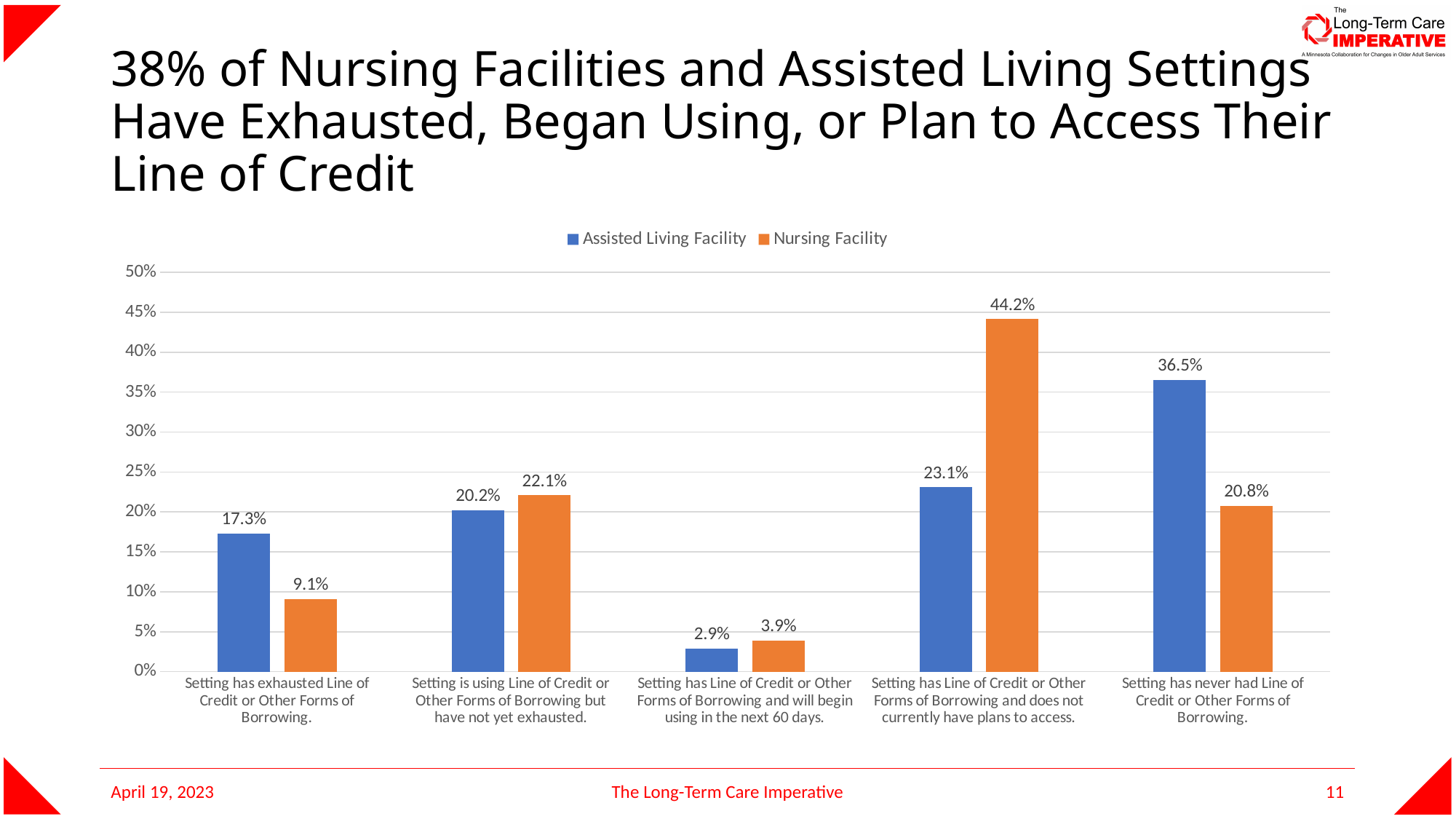
What is the Assisted Living Facility value for 'Setting has exhausted Line of Credit or Other Forms of Borrowing.'? 17.3% What is the Assisted Living Facility value for 'Setting has never had Line of Credit or Other Forms of Borrowing.'? 36.5% Which category has the highest Nursing Facility value? Setting has Line of Credit or Other Forms of Borrowing and does not currently have plans to access. Is the Nursing Facility value for 'Setting is using Line of Credit or Other Forms of Borrowing but have not yet exhausted.' greater or less than 20%? greater How many categories are shown on the x axis? 5 What is the difference between the Assisted Living Facility and Nursing Facility values for 'Setting has exhausted Line of Credit or Other Forms of Borrowing.'? 8.2% For 'Setting has never had Line of Credit or Other Forms of Borrowing.', which series has the larger value, Assisted Living Facility or Nursing Facility? Assisted Living Facility How many series does the legend list? 2 What kind of chart is shown on the slide? Bar chart Which category has the lowest Assisted Living Facility value? Setting has Line of Credit or Other Forms of Borrowing and will begin using in the next 60 days. What is the Nursing Facility value for 'Setting has Line of Credit or Other Forms of Borrowing and does not currently have plans to access.'? 44.2% What is the Nursing Facility value for 'Setting has Line of Credit or Other Forms of Borrowing and will begin using in the next 60 days.'? 3.9%